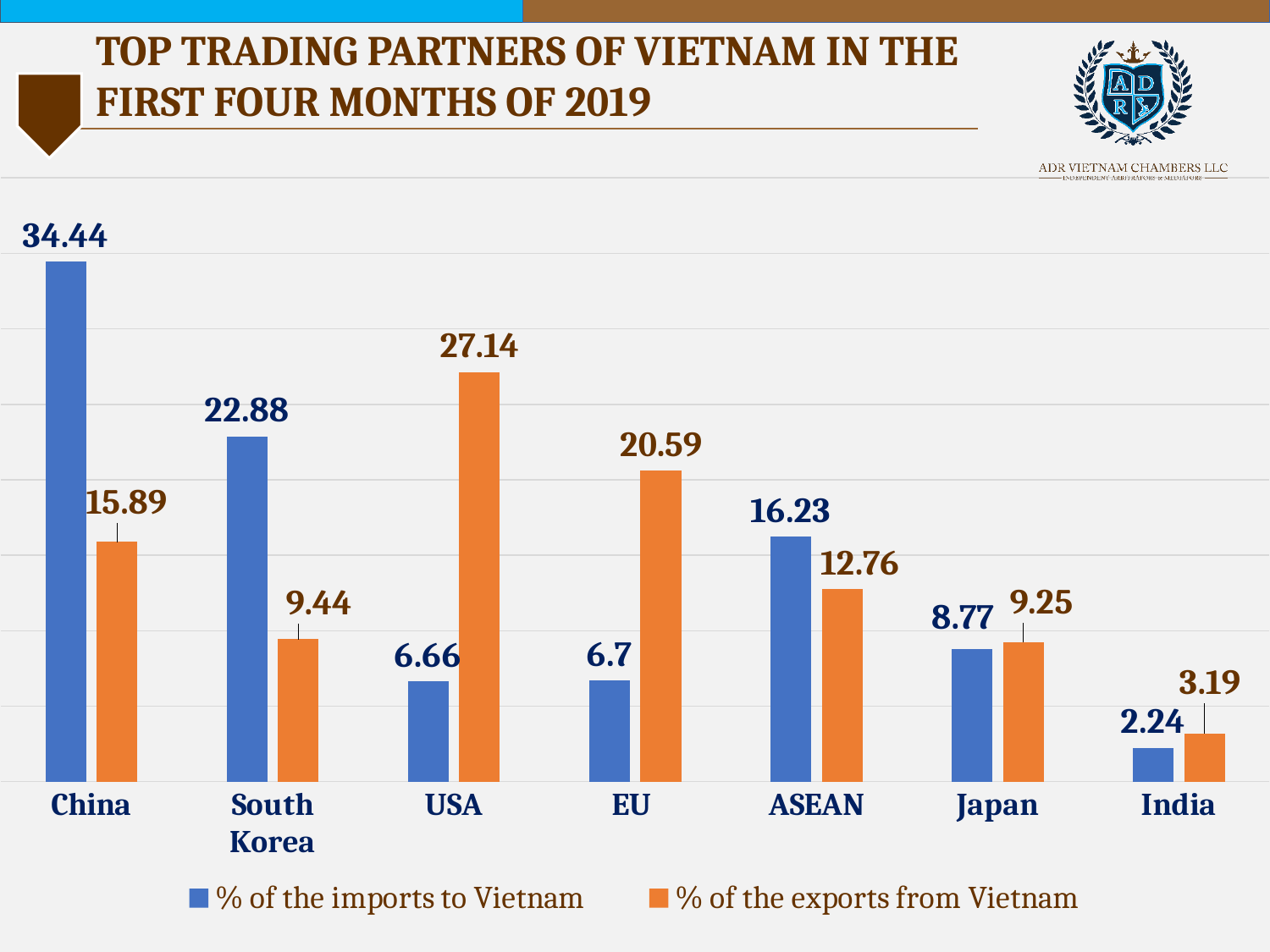
Which category has the lowest value in the '% of the imports to Vietnam' series? India What is the difference between the '% of the exports from Vietnam' values for USA and EU? 6.55 What is the difference between the '% of the imports to Vietnam' and '% of the exports from Vietnam' values for China? 18.55 What colour represents the '% of the exports from Vietnam' series? Orange How many trading partner categories are shown on the x axis? 7 What kind of chart is shown on the slide? Bar chart How many series does the legend list? 2 What is the value for China in the '% of the imports to Vietnam' series? 34.44 What is the value for USA in the '% of the exports from Vietnam' series? 27.14 Which category has the highest value in the '% of the exports from Vietnam' series? USA Which is larger for the EU: the '% of the imports to Vietnam' value or the '% of the exports from Vietnam' value? % of the exports from Vietnam What is the value for Japan in the '% of the imports to Vietnam' series? 8.77